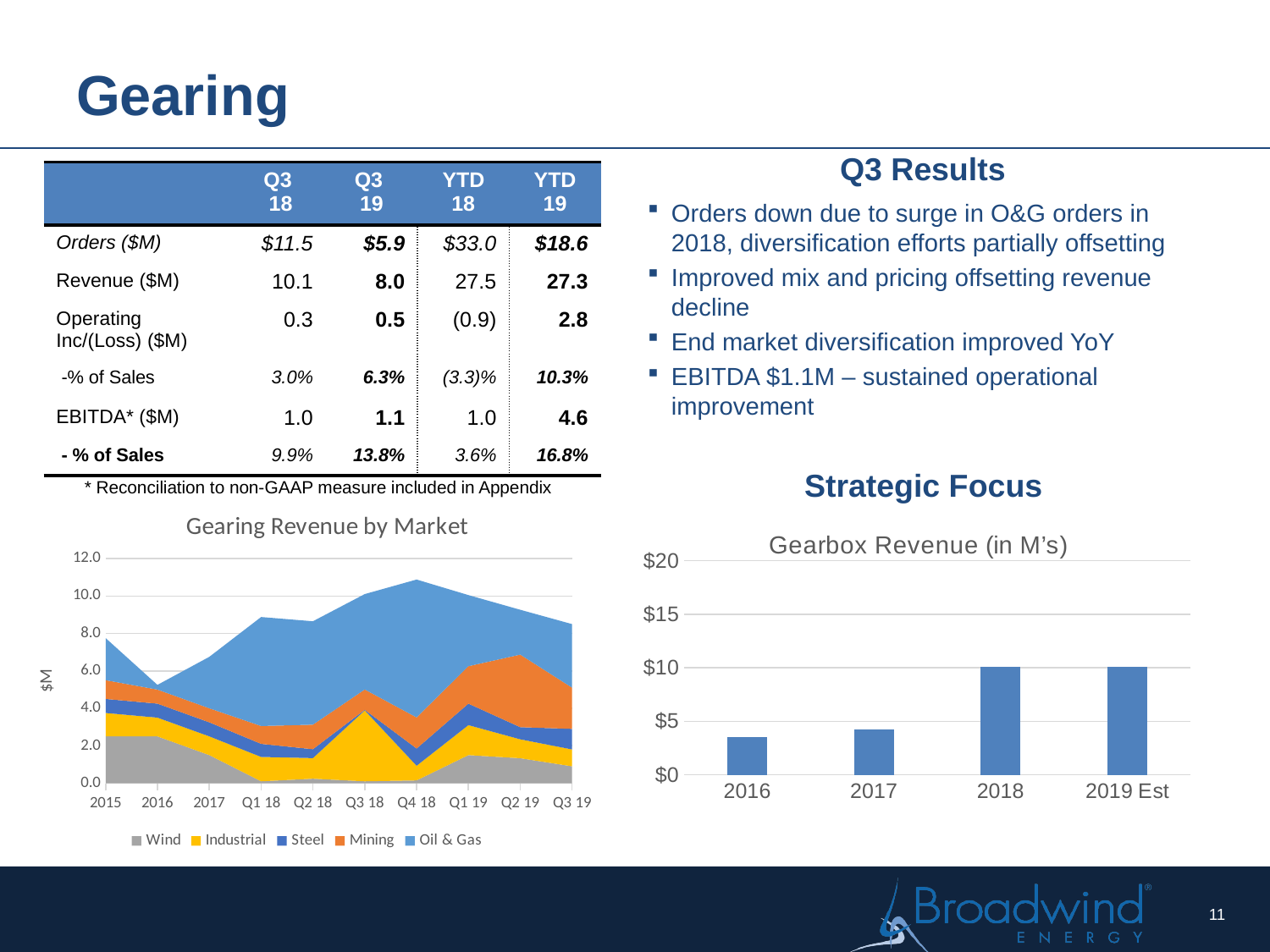
In the "Gearbox Revenue (in M's)" chart, is the value for 2018 greater or less than $5? greater How many periods are shown on the x axis of the "Gearing Revenue by Market" chart? 10 In the "Gearbox Revenue (in M's)" chart, which year has the lowest revenue? 2016 What kind of chart is the "Gearbox Revenue (in M's)" chart? bar chart How many series does the legend of the "Gearing Revenue by Market" chart list? 5 In the "Gearbox Revenue (in M's)" chart, which is larger, the value for 2017 or the value for 2018? 2018 In the "Gearing Revenue by Market" chart, which period has the highest total revenue? Q4 18 What kind of chart is the "Gearing Revenue by Market" chart? stacked area chart In the "Gearing Revenue by Market" chart, is the total revenue for 2016 greater or less than 6.0? less In the "Gearbox Revenue (in M's)" chart, is the value for 2016 greater or less than $5? less How many years are shown on the x axis of the "Gearbox Revenue (in M's)" chart? 4 What is the y-axis label of the "Gearing Revenue by Market" chart? $M